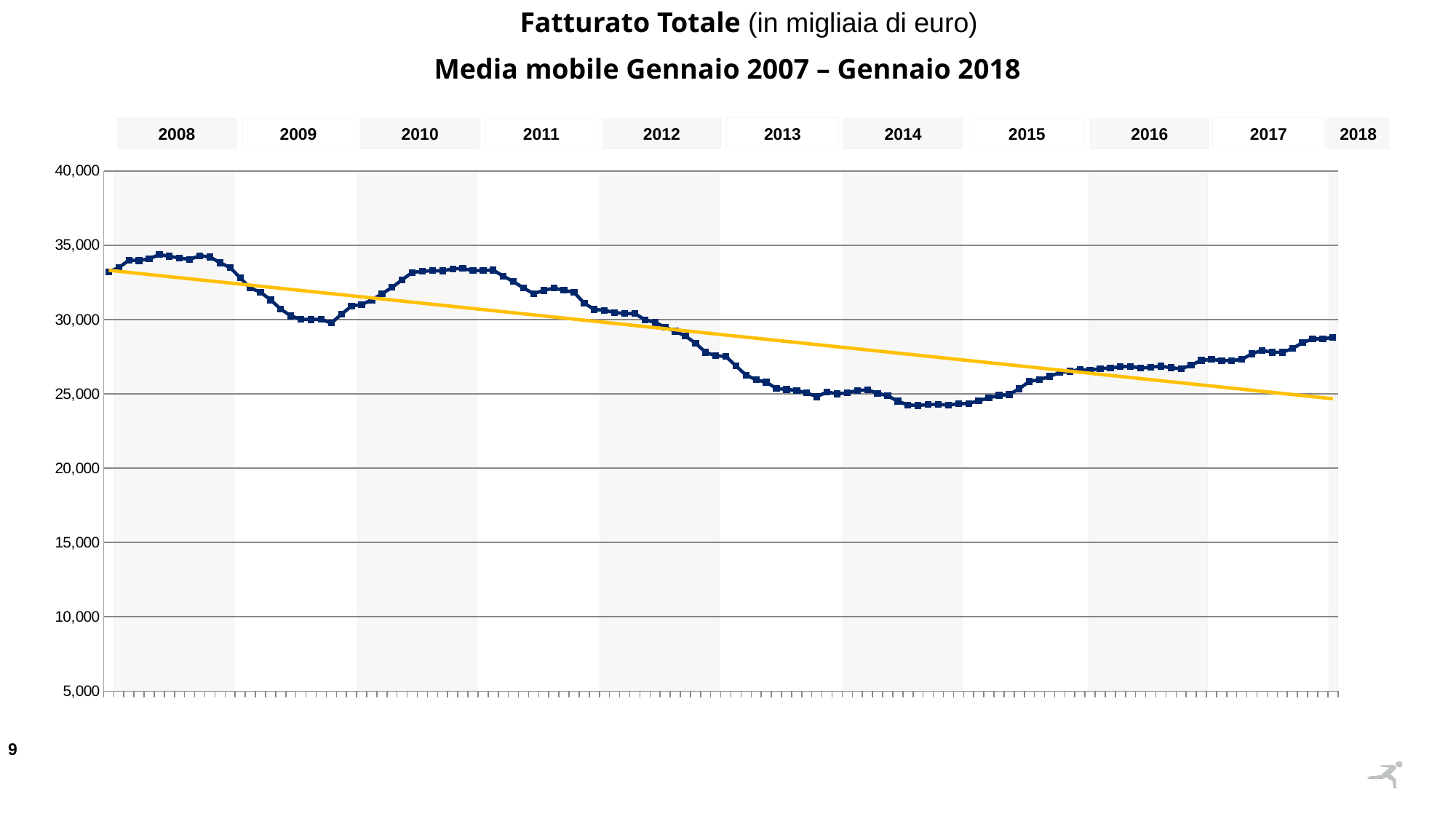
Is the value of the blue line at the start of 2008 greater or less than 30,000? greater Is the value of the blue line at the end of the series in 2018 greater or less than 25,000? greater Which is larger, the value of the blue line in early 2008 or in early 2014? early 2008 Overall, does the blue moving-average line rise or fall from 2008 to 2018? fall Does the yellow trend line rise or fall across the chart? fall In which year does the blue line reach its lowest values? 2014 What period does the subtitle say the moving average covers? Gennaio 2007 – Gennaio 2018 How many year labels are shown along the top of the chart? 11 Is the value of the blue line in the middle of 2010 greater or less than 30,000? greater What is the title of the chart? Fatturato Totale (in migliaia di euro) What kind of chart is shown on the slide? line chart